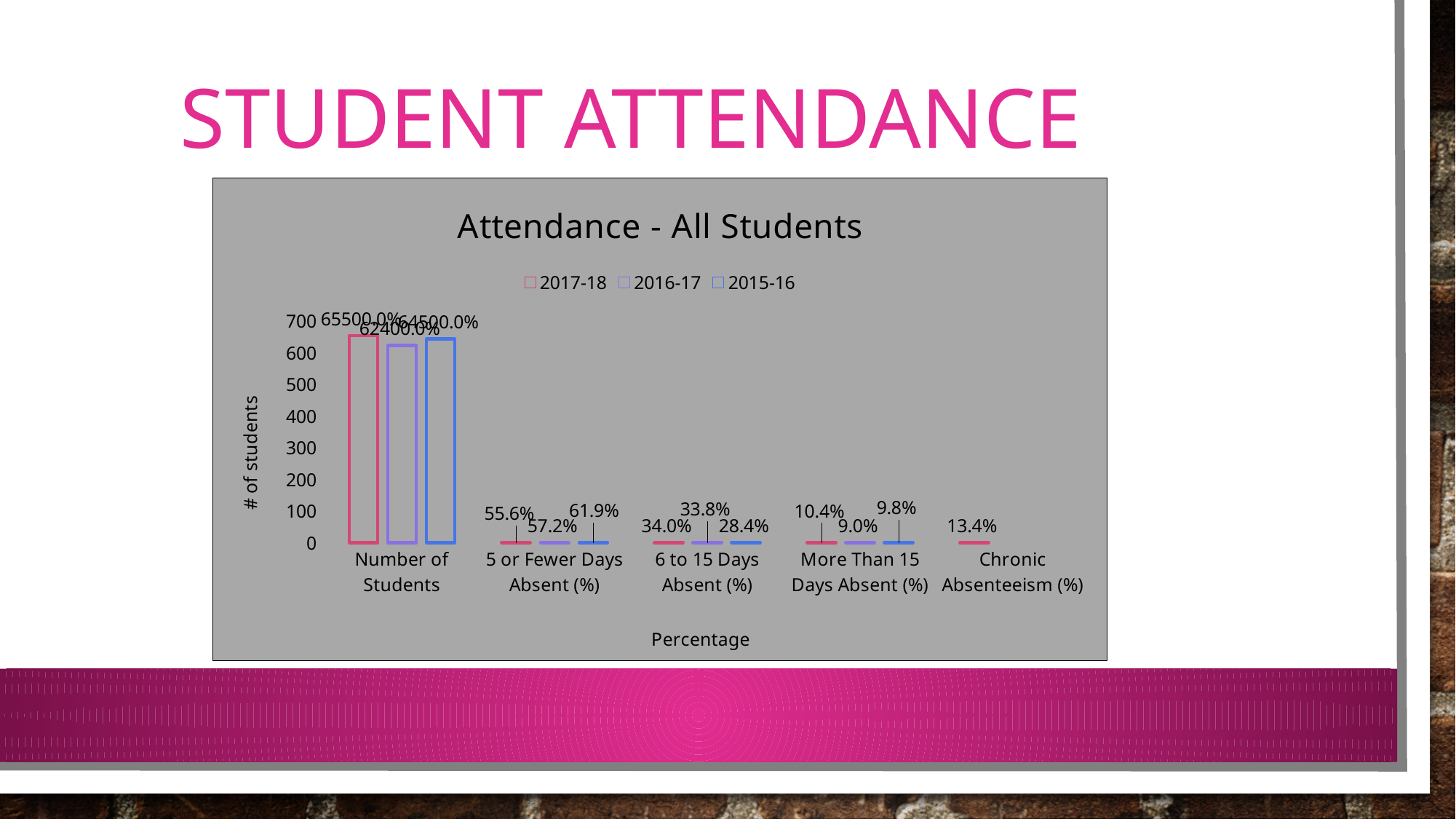
What type of chart is shown on the slide? bar chart What is the difference between the 2015-16 and 2017-18 values for 5 or Fewer Days Absent (%)? 6.3% What is the 2016-17 value for More Than 15 Days Absent (%)? 9.0% What is the title of the chart? Attendance - All Students How many series does the legend list in the Attendance - All Students chart? 3 What is the 2017-18 value for Chronic Absenteeism (%)? 13.4% How many categories are shown on the x axis of the chart? 5 Is the 2017-18 value for Number of Students greater or less than 600? greater What is the 2015-16 value for 5 or Fewer Days Absent (%)? 61.9% What is the 2017-18 value for 6 to 15 Days Absent (%)? 34.0% Which year has the highest value for 5 or Fewer Days Absent (%)? 2015-16 For 6 to 15 Days Absent (%), which is larger: the 2017-18 value or the 2015-16 value? 2017-18